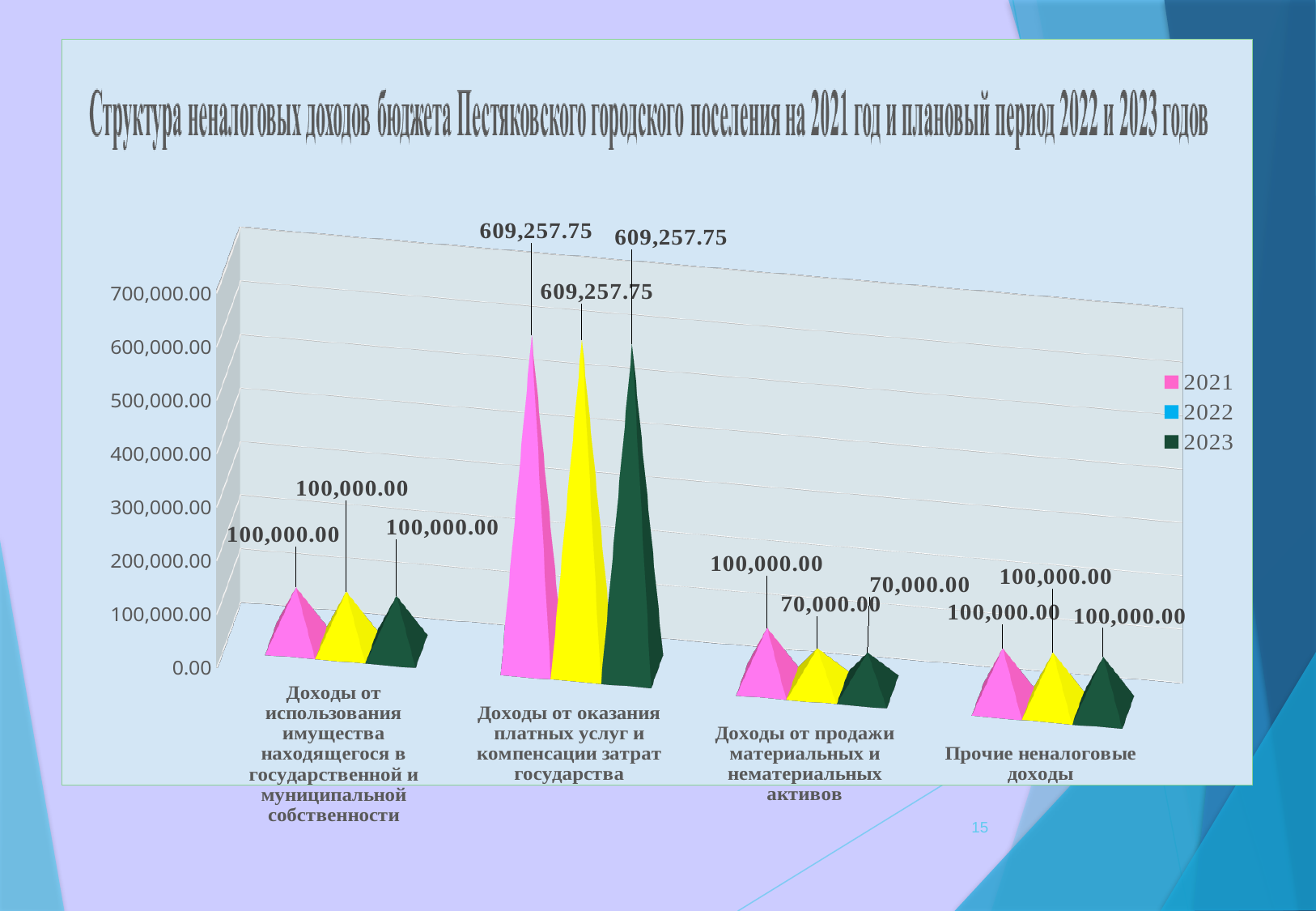
What is the value for 2021 for "Прочие неналоговые доходы"? 100,000.00 How many categories are shown on the x axis? 4 What is the difference between the 2021 and 2023 values for "Доходы от продажи материальных и нематериальных активов"? 30,000.00 What is the value for 2022 for "Доходы от продажи материальных и нематериальных активов"? 70,000.00 Which is larger: the 2021 value for "Доходы от оказания платных услуг и компенсации затрат государства" or the 2021 value for "Прочие неналоговые доходы"? Доходы от оказания платных услуг и компенсации затрат государства How many series does the legend list? 3 Which category has the lowest value for 2022? Доходы от продажи материальных и нематериальных активов Which category has the highest value for 2023? Доходы от оказания платных услуг и компенсации затрат государства Is the 2022 value for "Доходы от оказания платных услуг и компенсации затрат государства" greater or less than 500,000.00? greater What kind of chart is shown on the slide? bar chart What is the value for 2023 for "Доходы от использования имущества находящегося в государственной и муниципальной собственности"? 100,000.00 What is the value for 2021 for "Доходы от оказания платных услуг и компенсации затрат государства"? 609,257.75